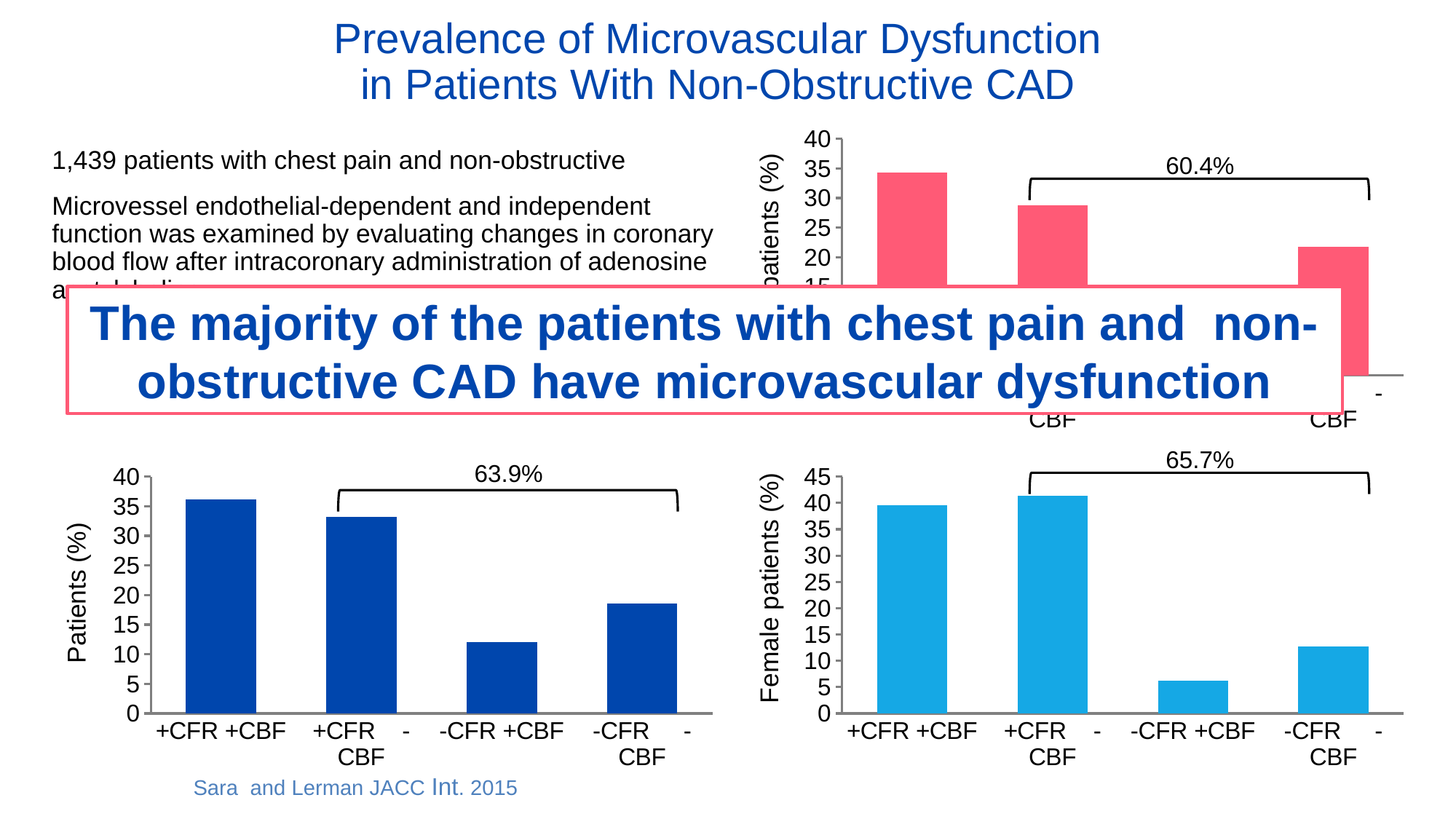
How many categories are shown on the x axis of the bottom-left chart (Patients (%))? 4 In the bottom-right chart (Female patients (%)), is the value for +CFR -CBF greater or less than 35? greater In the bottom-right chart (Female patients (%)), which is larger, the bar for -CFR -CBF or the bar for -CFR +CBF? -CFR -CBF In the bottom-right chart (Female patients (%)), is the value for -CFR +CBF greater or less than 10? less In the bottom-left chart (Patients (%)), which category has the highest bar? +CFR +CBF In the bottom-left chart (Patients (%)), which category has the lowest bar? -CFR +CBF In the bottom-left chart (Patients (%)), is the value for +CFR +CBF greater or less than 30? greater What percentage is printed above the bracket in the bottom-right chart (Female patients (%))? 65.7% In the bottom-left chart (Patients (%)), which is larger, the bar for -CFR -CBF or the bar for -CFR +CBF? -CFR -CBF What kind of chart is the bottom-left chart labelled 'Patients (%)'? bar chart In the bottom-right chart (Female patients (%)), which category has the lowest bar? -CFR +CBF